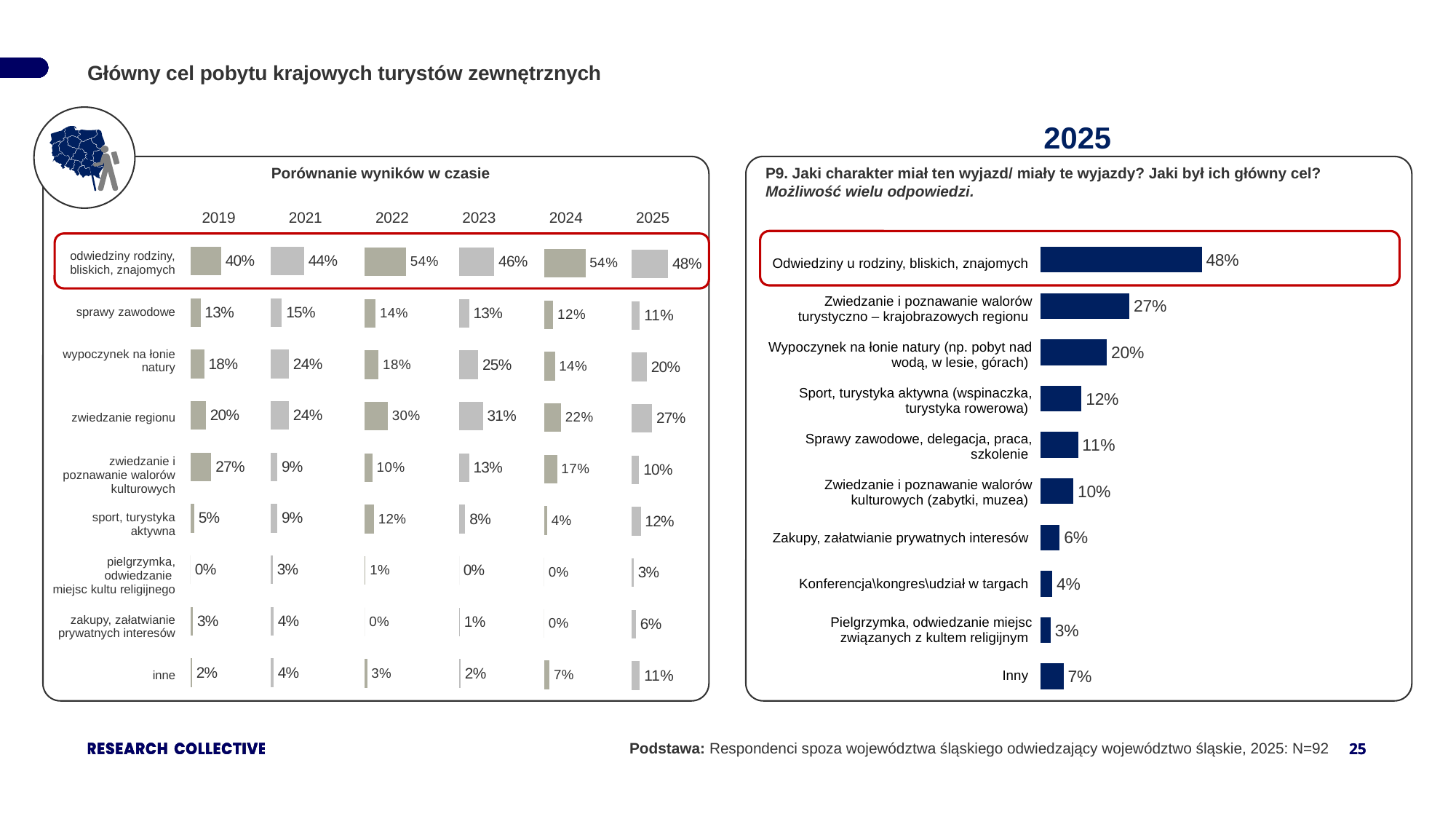
In the 2025 chart on the right, what is the difference between 'Odwiedziny u rodziny, bliskich, znajomych' and 'Zwiedzanie i poznawanie walorów turystyczno – krajobrazowych regionu'? 21 percentage points What kind of chart is the 2025 chart on the right? Bar chart In the 'Porównanie wyników w czasie' chart on the left, in which year was 'zwiedzanie regionu' highest? 2023 In the 2025 chart on the right, which category has the lowest value? Pielgrzymka, odwiedzanie miejsc związanych z kultem religijnym In the 'Porównanie wyników w czasie' chart on the left, which year has the larger value for 'wypoczynek na łonie natury': 2023 or 2024? 2023 In the 2025 chart on the right, what is the value for 'Inny'? 7% How many categories are shown in the 2025 chart on the right? 10 In the 2025 chart on the right, which category has the highest value? Odwiedziny u rodziny, bliskich, znajomych In the 2025 chart on the right, what is the value for 'Zwiedzanie i poznawanie walorów turystyczno – krajobrazowych regionu'? 27% How many years are compared in the 'Porównanie wyników w czasie' chart on the left? 6 In the 'Porównanie wyników w czasie' chart on the left, what is the value for 'sprawy zawodowe' in 2021? 15% In the 'Porównanie wyników w czasie' chart on the left, what is the value for 'odwiedziny rodziny, bliskich, znajomych' in 2022? 54%